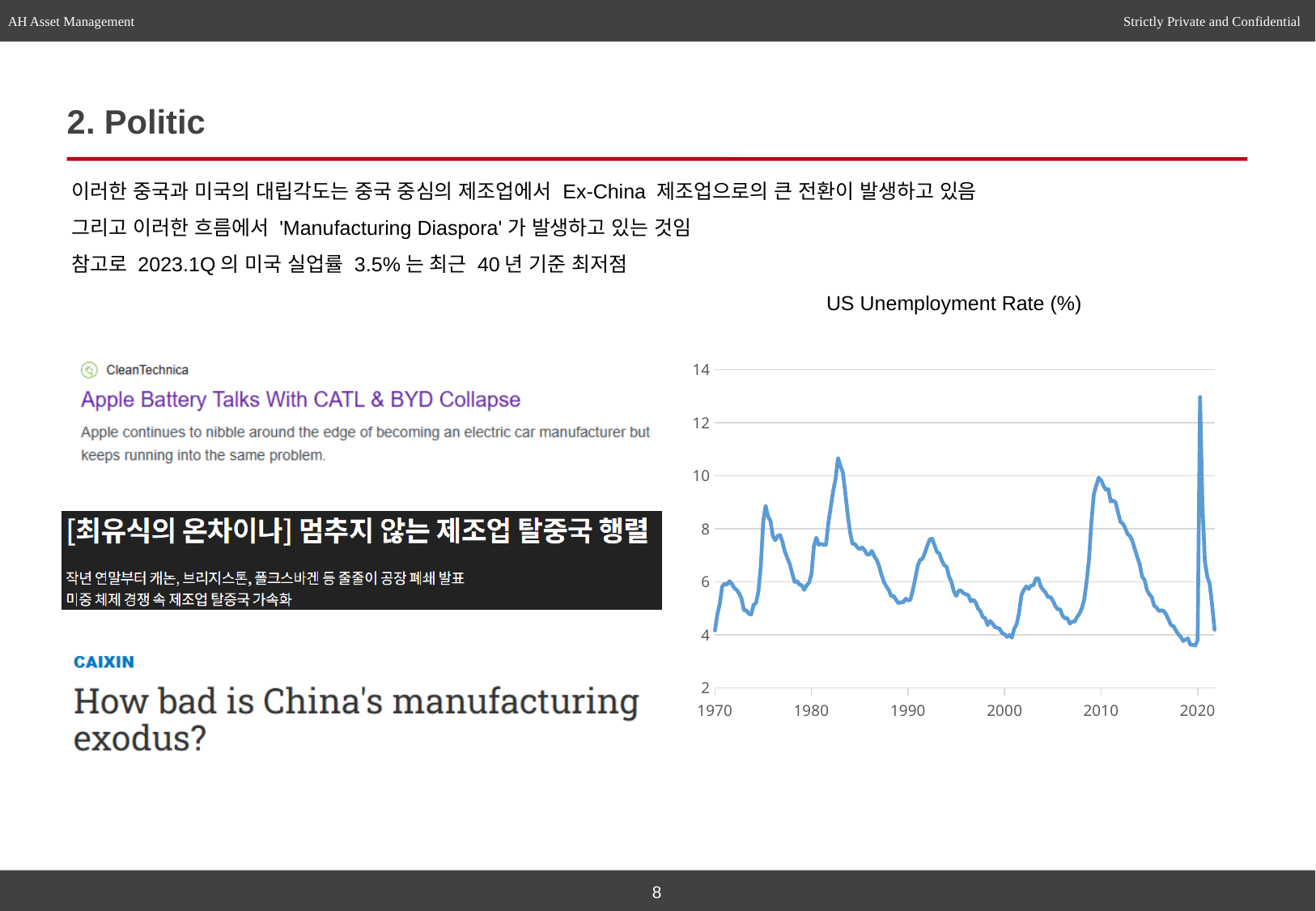
Which is higher on the chart: the peak of the US unemployment rate in the early 1980s or the peak in the mid-1970s? the early 1980s What is the title of the chart on the slide? US Unemployment Rate (%) What is the highest value labelled on the y axis of the US Unemployment Rate chart? 14 What kind of chart is used to show the US Unemployment Rate (%)? line chart Is the peak of the US unemployment rate around 2010 greater or less than 8? greater Is the peak value of the US unemployment rate around 2020 greater or less than 12? greater Is the lowest value of the US unemployment rate just before 2020 greater or less than 4? less In which period does the US unemployment rate reach its highest point on the chart: the early 1980s, around 2010, or around 2020? around 2020 How many year labels are shown on the x axis of the US Unemployment Rate chart? 6 Does the US unemployment rate rise or fall between 2010 and 2019? fall